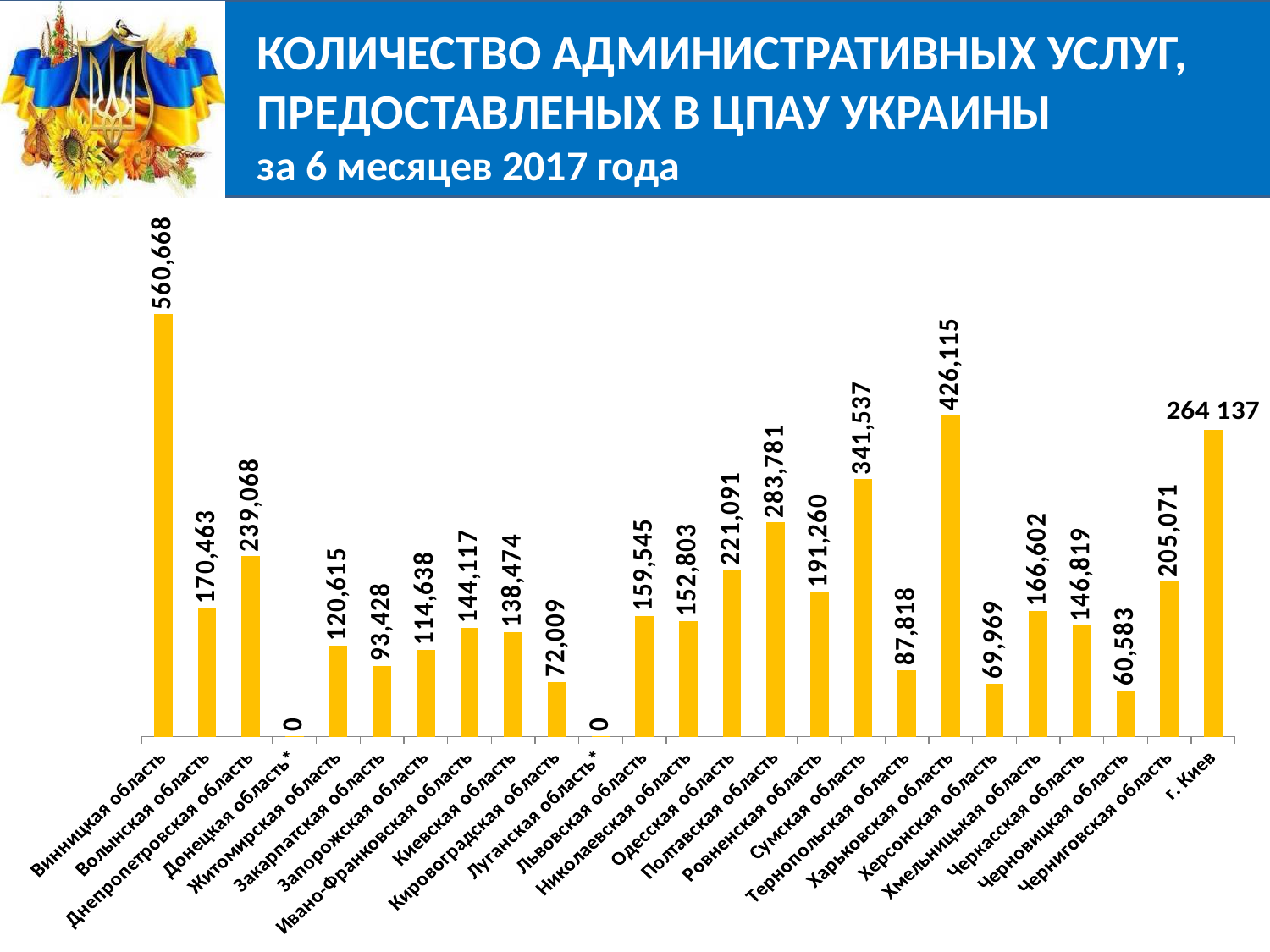
How many categories show a value of 0? 2 What kind of chart is shown on the slide? Bar chart What is the difference between the values for Харьковская область and Сумская область? 84,578 How many categories are shown on the x axis? 25 What is the value for Харьковская область? 426,115 What is the value for Полтавская область? 283,781 Which category has the highest value? Винницкая область What is the value for Винницкая область? 560,668 What is the value for Черновицкая область? 60,583 What is the value for г. Киев? 264 137 Which category has the lowest non-zero value? Черновицкая область